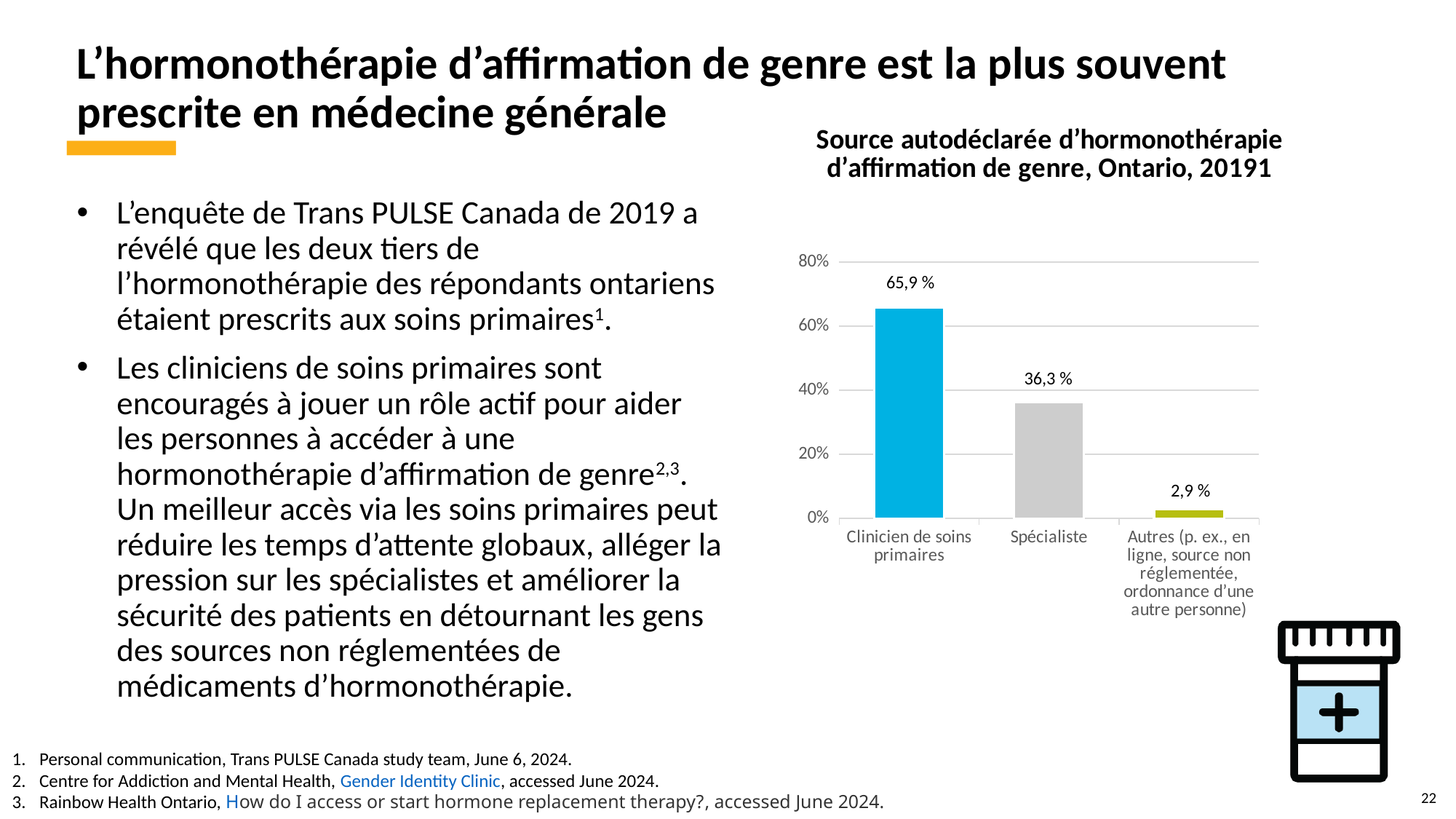
What kind of chart is shown on the slide? bar chart What is the difference between the values for Clinicien de soins primaires and Spécialiste? 29,6 % What is the value for Spécialiste? 36,3 % What is the value for Clinicien de soins primaires? 65,9 % Which category has the highest value? Clinicien de soins primaires What is the value for the Autres category (e.g. en ligne, source non réglementée, ordonnance d'une autre personne)? 2,9 % Which category has the lowest value? Autres (p. ex., en ligne, source non réglementée, ordonnance d'une autre personne) Do the values rise or fall from left to right across the categories? fall Which is larger, the value for Spécialiste or the value for Autres? Spécialiste Is the value for Spécialiste greater or less than 40%? less What is the title of the chart? Source autodéclarée d'hormonothérapie d'affirmation de genre, Ontario, 20191 How many categories are shown on the chart? 3